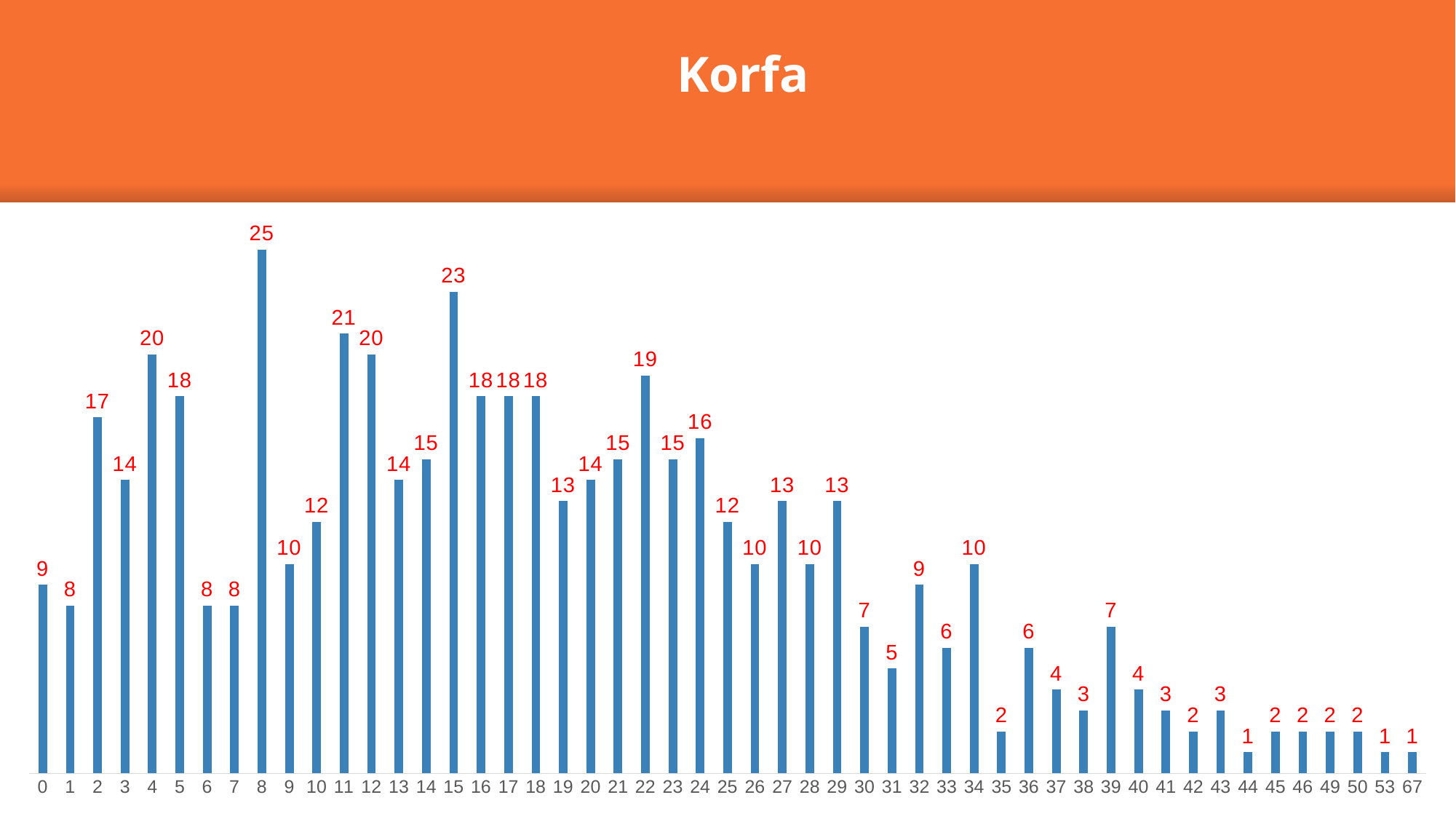
What is the difference between the values for category 8 and category 15? 2 What is the difference between the values for category 4 and category 30? 13 Which has a larger value, category 11 or category 22? 11 What is the value for category 15? 23 What is the value for category 34? 10 How many bars are plotted on the chart? 51 What is the title of the chart? Korfa What kind of chart is shown on the slide? bar chart Which category has the highest value? 8 What is the lowest value shown on the chart? 1 What is the value for category 67? 1 What is the value for category 8? 25